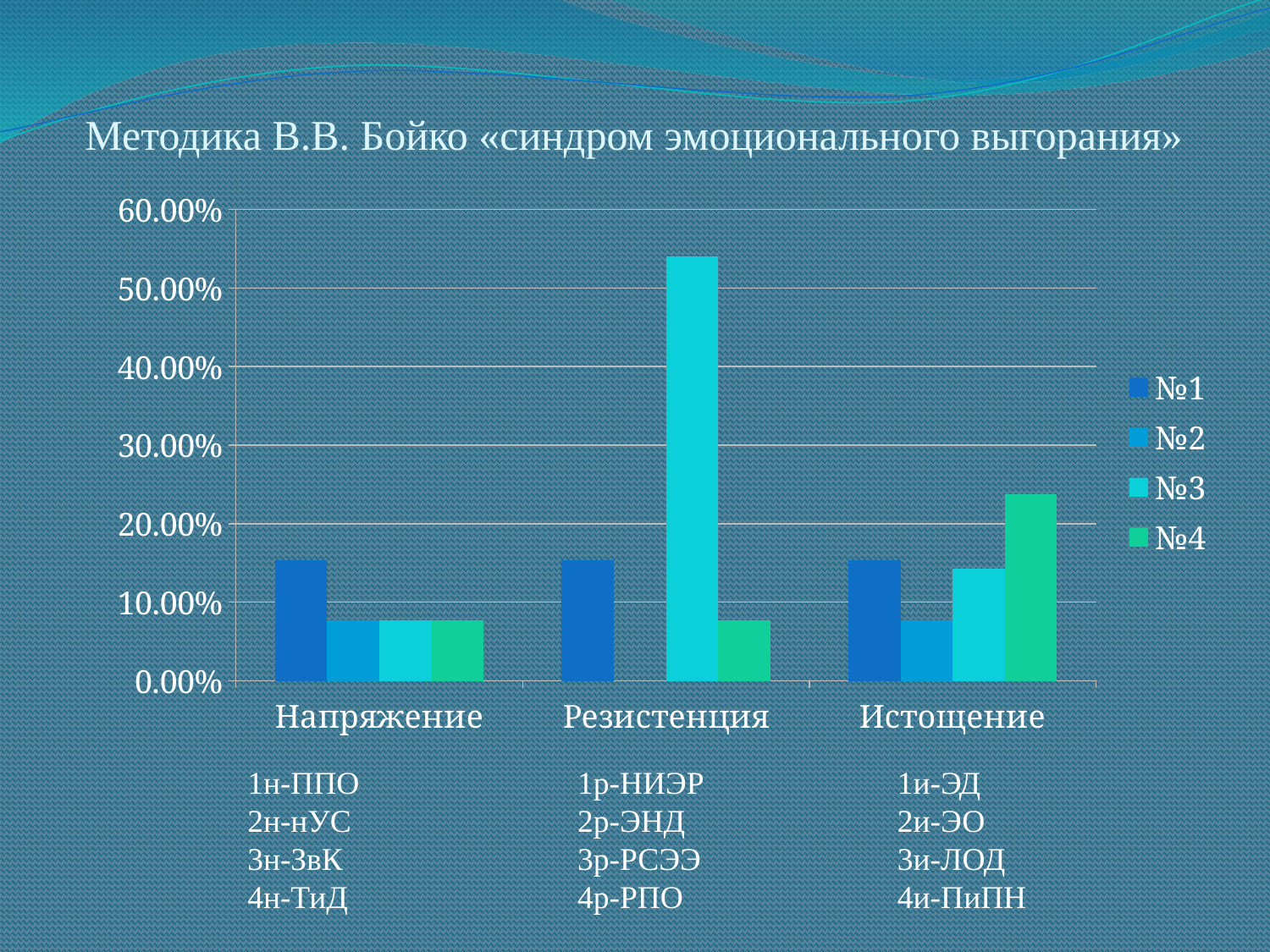
Is the value for №3 in Резистенция greater or less than 50.00%? greater Which series has the tallest bar in the Истощение category? №4 Which is larger in the Истощение category: the value for №4 or the value for №1? №4 Which series has the tallest bar in the Резистенция category? №3 How many categories are shown on the x axis of the chart? 3 Is the value for №1 in Напряжение greater or less than 20.00%? less Which category contains the tallest bar in the chart? Резистенция What is the title of the slide above the chart? Методика В.В. Бойко «синдром эмоционального выгорания» What kind of chart is shown on the slide? bar chart How many series does the legend list? 4 Is the value for №4 in Истощение greater or less than 20.00%? greater